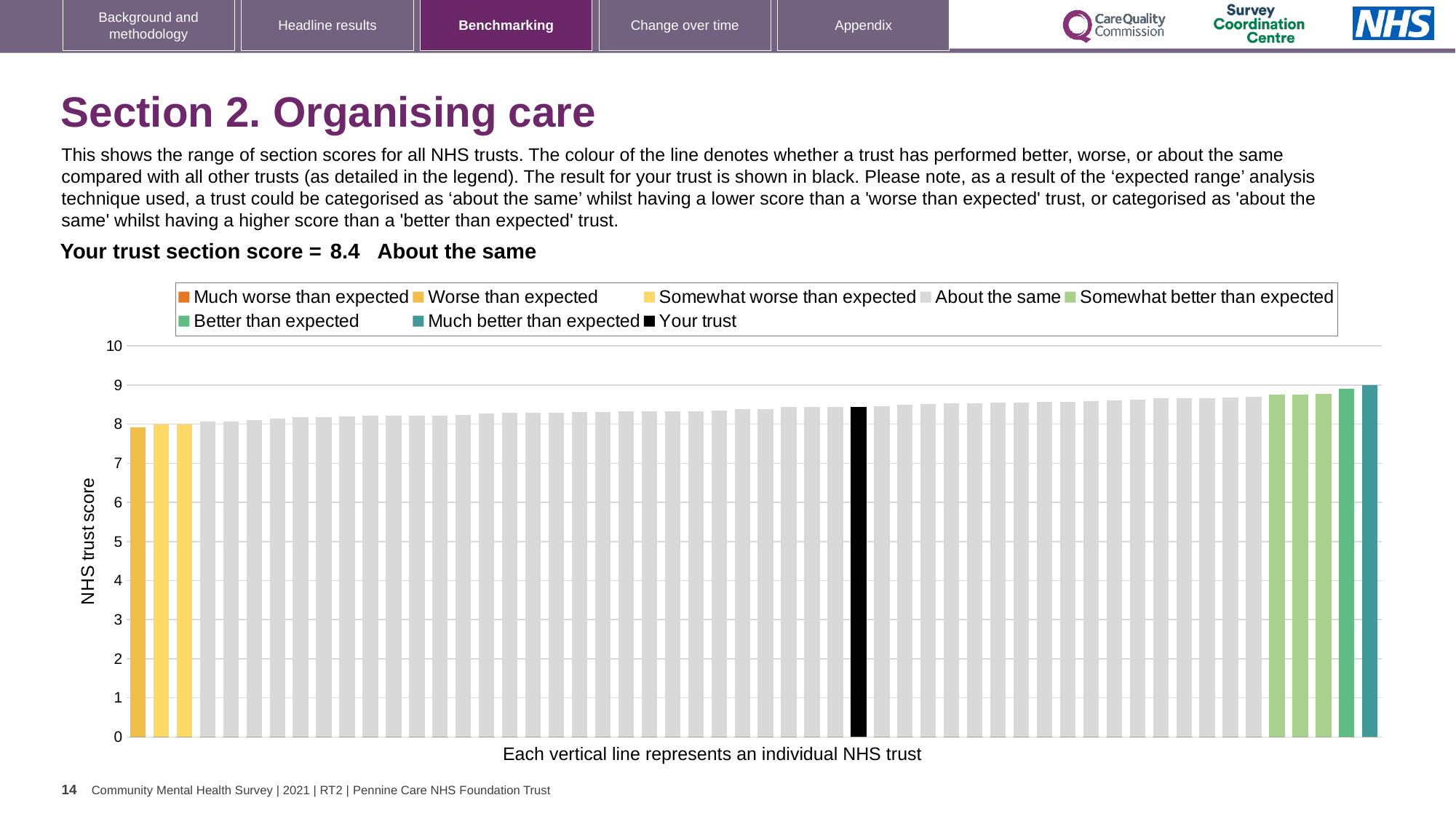
Is the value of the rightmost bar greater or less than 8? greater How many entries does the chart legend list? 8 Which legend category does the lowest bar belong to? Worse than expected Is the value of the leftmost bar greater or less than 7? greater Which legend category does the highest bar belong to? Much better than expected What is the label on the vertical axis of the chart? NHS trust score What is the section score for your trust shown on the slide? 8.4 Is the value of the black bar (your trust) greater or less than 8? greater What kind of chart is shown on the slide? bar chart Do the bar values rise or fall from left to right along the x axis? rise Which category is your trust placed in for this section? About the same What colour is used for the bar representing your trust? black